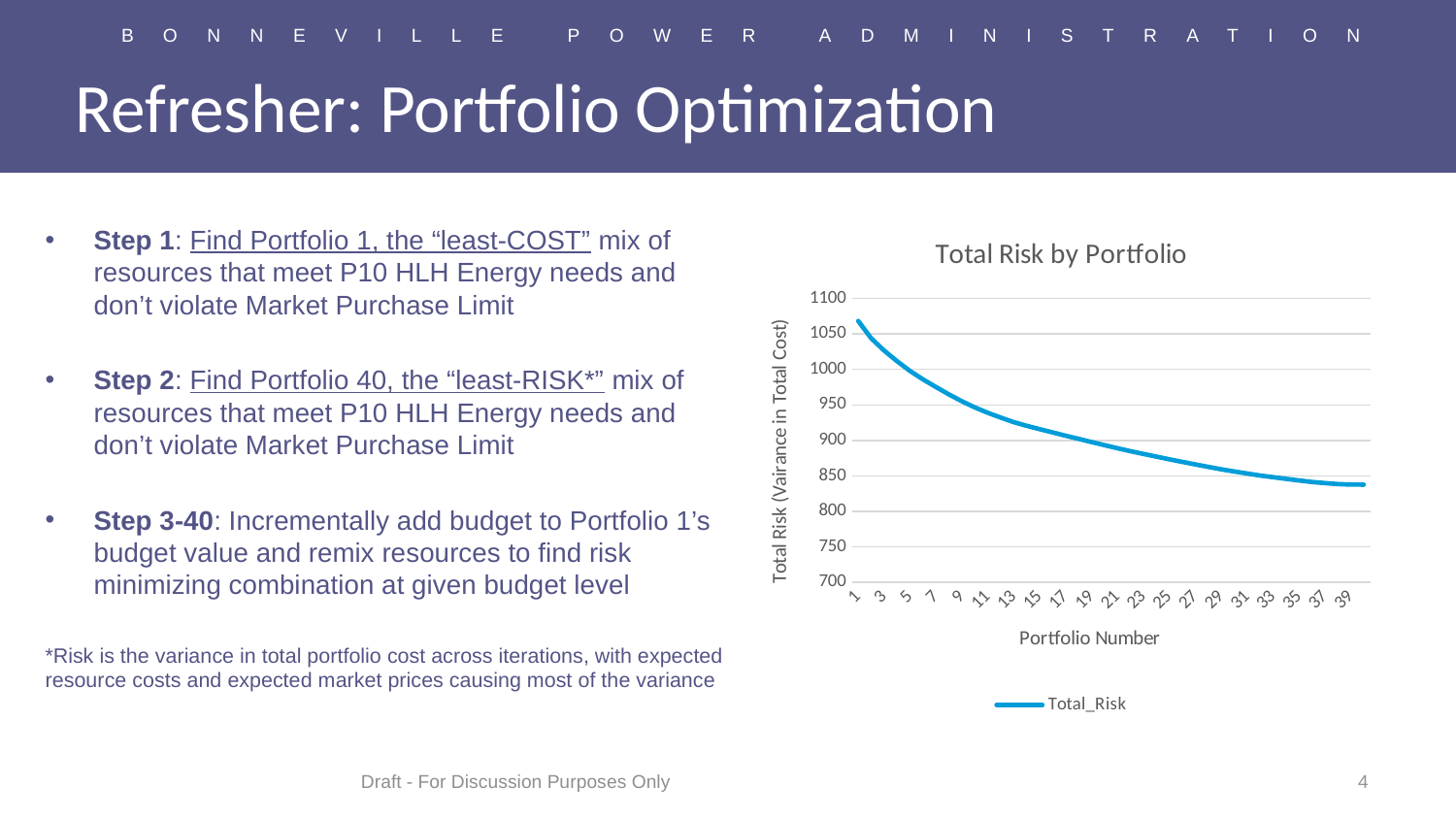
Is the Total_Risk value for Portfolio 1 greater or less than 1000? greater What is the name of the series shown in the chart legend? Total_Risk Does Total_Risk rise or fall as the Portfolio Number increases? fall What kind of chart is shown on the slide? line chart Is the Total_Risk value for Portfolio 39 greater or less than 850? less How many series does the chart legend list? 1 What is the label of the x axis of the chart? Portfolio Number Which portfolio has the higher Total_Risk, Portfolio 5 or Portfolio 25? Portfolio 5 Is the Total_Risk value for Portfolio 31 greater or less than 900? less Which portfolio number has the highest Total_Risk in the chart? 1 What is the title of the chart? Total Risk by Portfolio